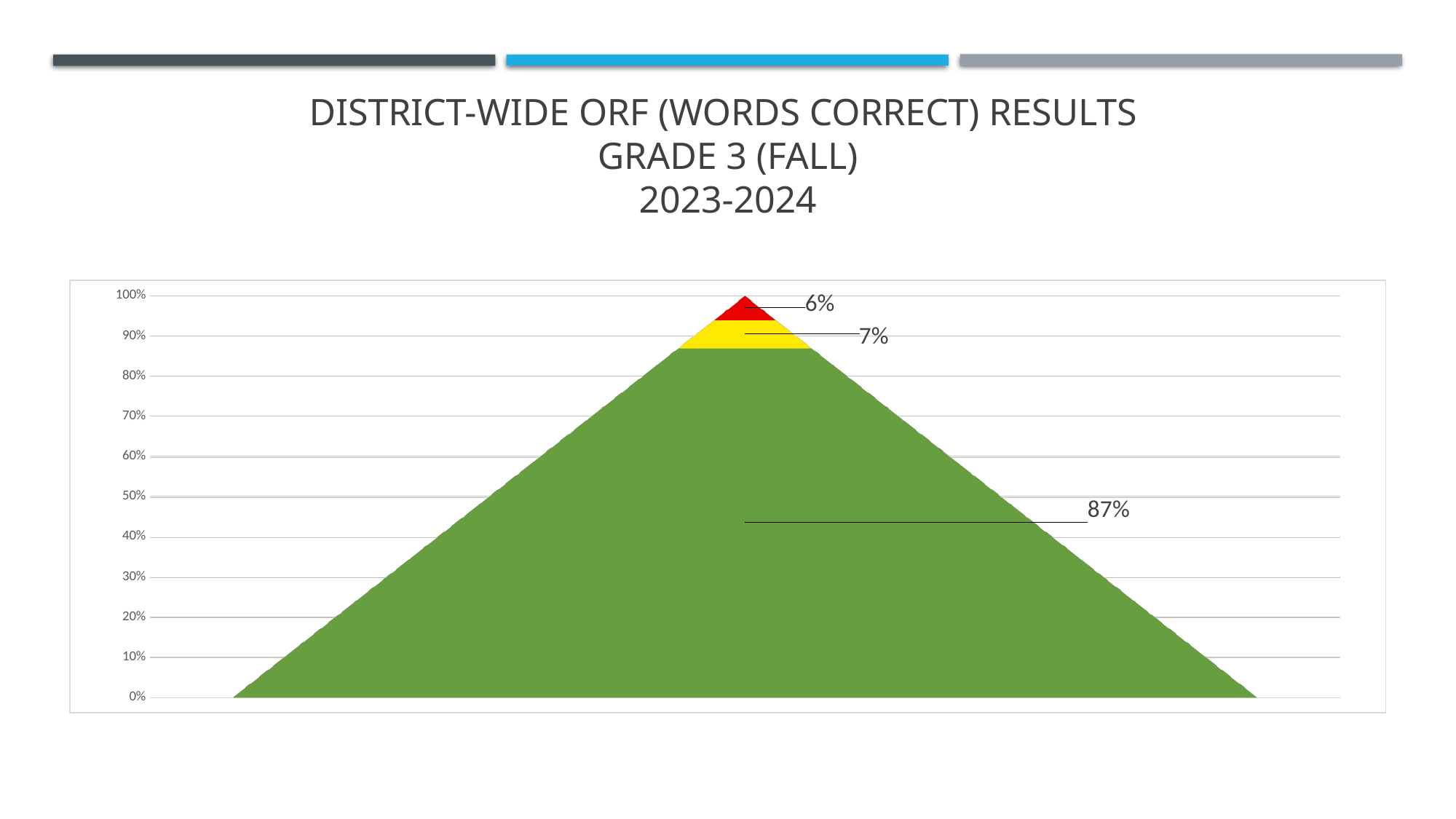
Which coloured segment has the smallest value? red Is the value for the green segment greater or less than 80%? greater What is the title of the chart on the slide? District-Wide ORF (Words Correct) Results Grade 3 (Fall) 2023-2024 What is the difference between the green segment's value and the yellow segment's value? 80% What value is labelled on the yellow segment of the pyramid? 7% What is the total of the three labelled segments? 100% Which is larger, the yellow segment's value or the red segment's value? yellow What is the difference between the yellow segment's value and the red segment's value? 1% How many segments make up the stacked pyramid? 3 What value is labelled on the red segment at the top of the pyramid? 6% Which coloured segment has the largest value? green What value is labelled on the green segment of the pyramid? 87%